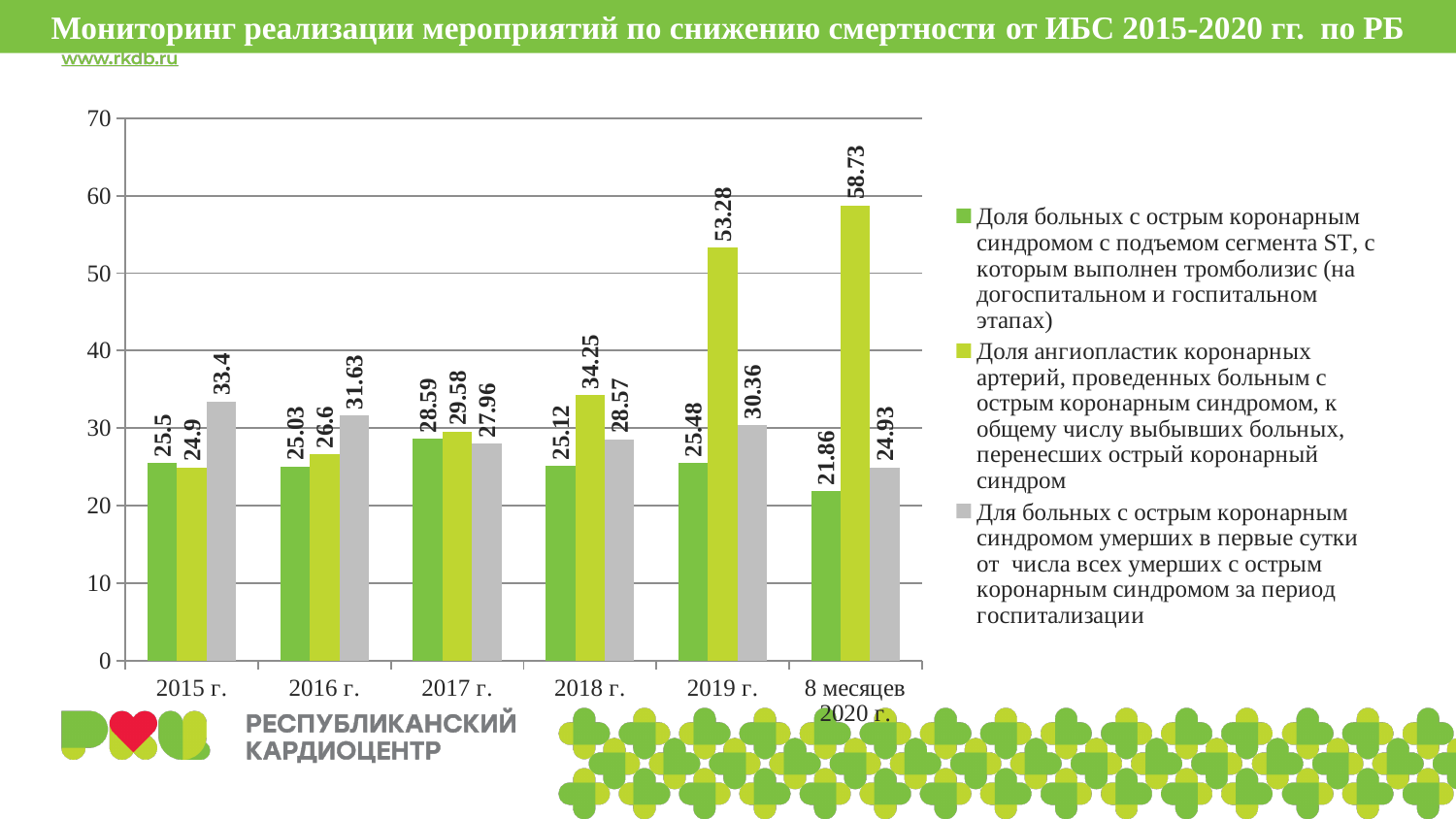
What is the difference between the angioplasty share in 8 месяцев 2020 г. and in 2019 г.? 5.45 What is the value of the first-day mortality share (умерших в первые сутки) for 2015 г.? 33.4 Does the angioplasty share rise or fall from 2015 г. to 8 месяцев 2020 г.? rise In which period is the thrombolysis share (Доля больных с острым коронарным синдромом с подъемом сегмента ST, с которым выполнен тромболизис) lowest? 8 месяцев 2020 г. Which is larger in 2018 г.: the angioplasty share or the first-day mortality share? the angioplasty share (34.25) How many series does the legend list? 3 What type of chart is shown on the slide? bar chart In which period is the angioplasty share (Доля ангиопластик коронарных артерий) highest? 8 месяцев 2020 г. Is the angioplasty share for 2019 г. greater or less than 50? greater How many year categories are shown on the x axis? 6 What is the value of the thrombolysis share (Доля больных с острым коронарным синдромом с подъемом сегмента ST, с которым выполнен тромболизис) for 2017 г.? 28.59 What is the value of the angioplasty share (Доля ангиопластик коронарных артерий) for 2019 г.? 53.28